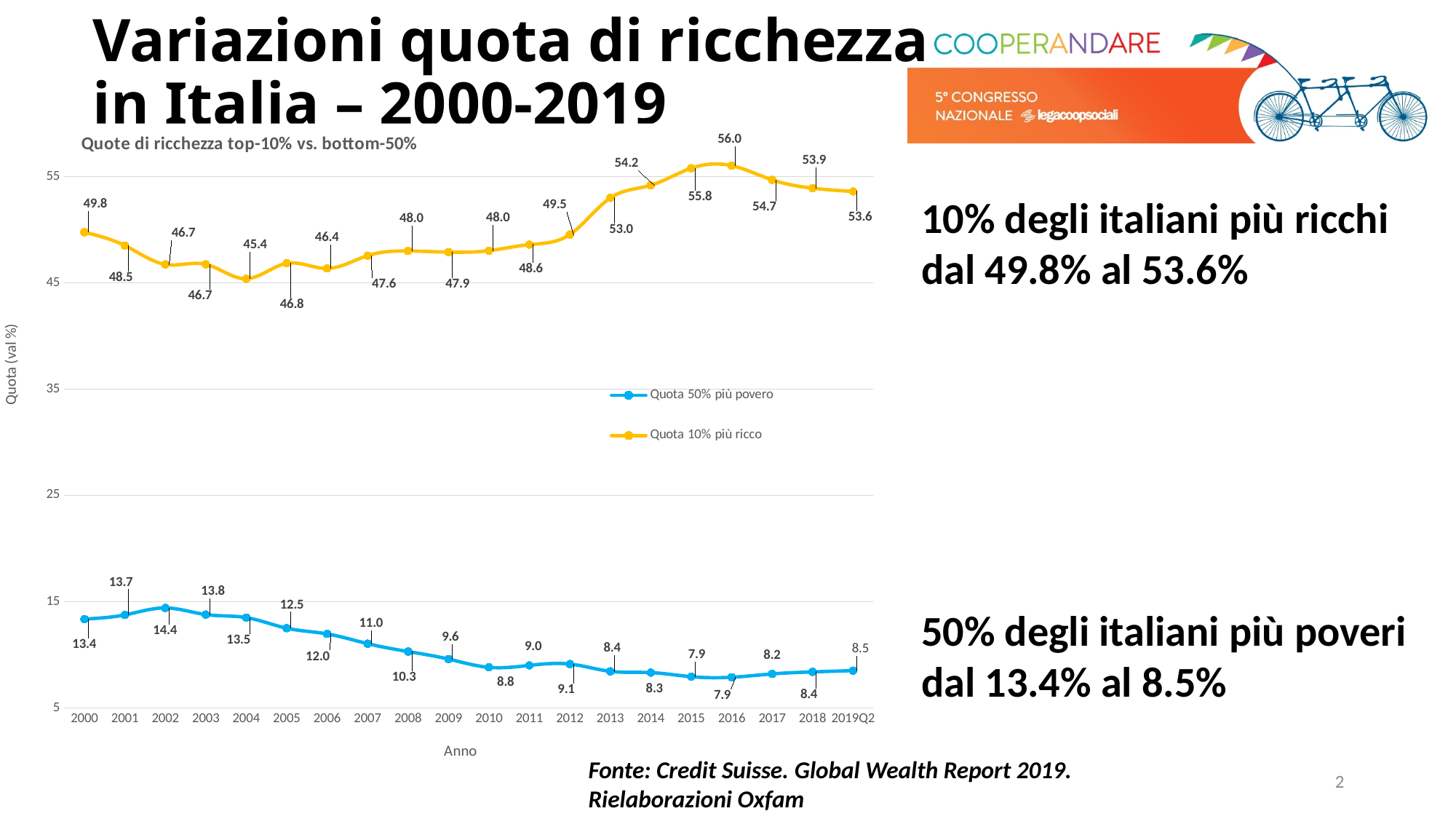
In which year does 'Quota 50% più povero' reach its highest value? 2002 How many series does the chart legend list? 2 Which is larger: 'Quota 50% più povero' in 2005 or in 2010? 2005 What is the difference between the 'Quota 50% più povero' value in 2000 and in 2019Q2? 4.9 In which year does 'Quota 10% più ricco' reach its lowest value? 2004 What is the value of 'Quota 10% più ricco' in 2016? 56.0 In which year does 'Quota 10% più ricco' reach its highest value? 2016 What is the value of 'Quota 10% più ricco' in 2004? 45.4 How many years (x-axis points) are plotted on the chart? 20 What is the value of 'Quota 50% più povero' in 2002? 14.4 What is the difference between the 'Quota 10% più ricco' value in 2019Q2 and in 2000? 3.8 What type of chart is shown on the slide? line chart